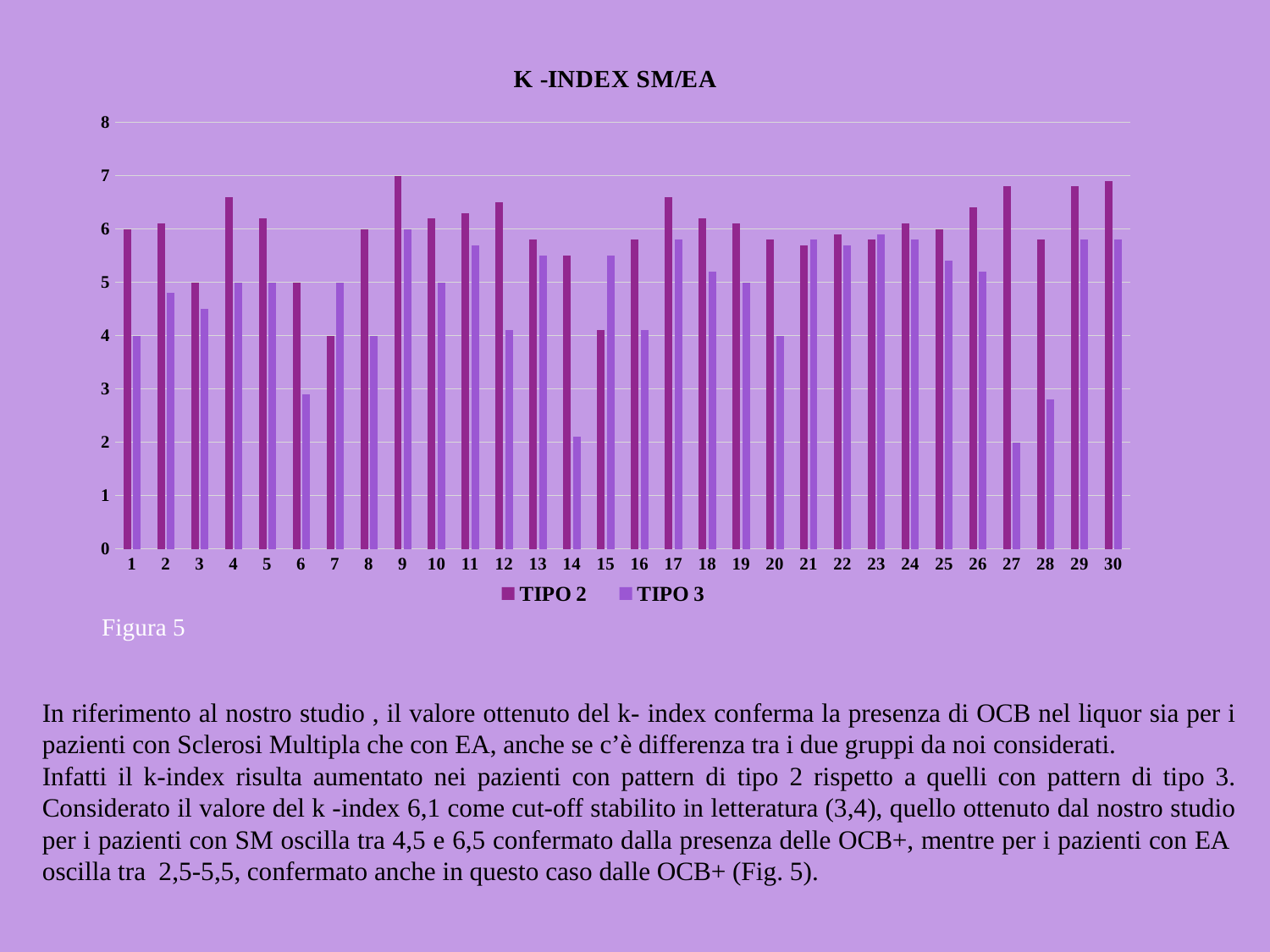
What kind of chart is shown on the slide? bar chart What is the TIPO 2 value for category 7? 4 What is the title of the chart? K -INDEX SM/EA How many categories are shown on the x axis? 30 Is the TIPO 2 value for category 30 greater or less than 6? greater For category 28, which series has the larger value, TIPO 2 or TIPO 3? TIPO 2 What is the TIPO 2 value for category 9? 7 What are the two series named in the legend? TIPO 2 and TIPO 3 For category 14, which series has the larger value, TIPO 2 or TIPO 3? TIPO 2 How many series does the legend list? 2 What is the TIPO 3 value for category 27? 2